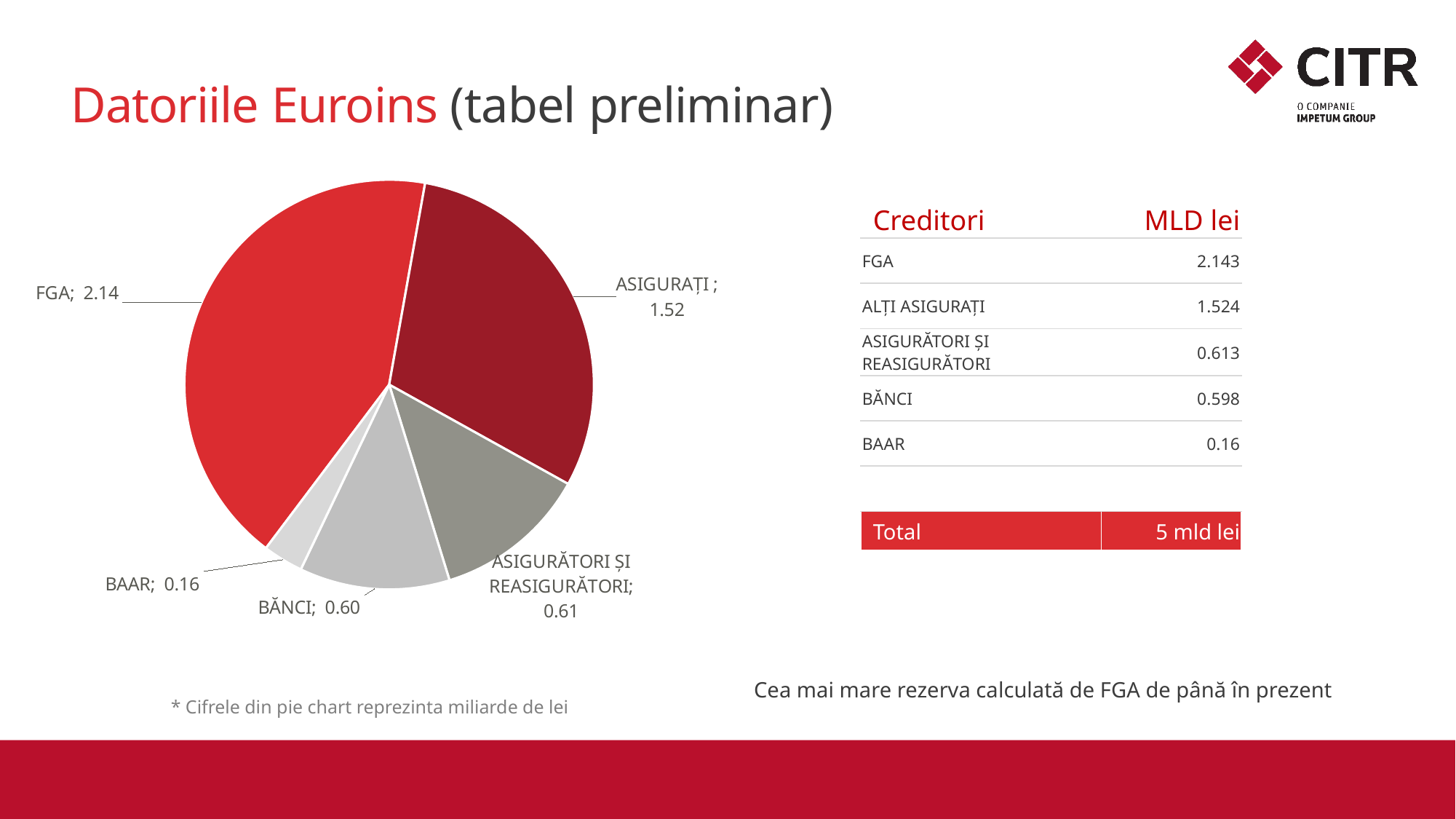
Which slice of the pie chart is the smallest? BAAR What is the value shown for BĂNCI in the pie chart? 0.60 According to the footnote, what unit do the figures in the pie chart represent? miliarde de lei Which slice of the pie chart is the largest? FGA What kind of chart is shown on the slide? pie chart What is the value shown for FGA in the pie chart? 2.14 What is the value shown for ASIGURĂTORI ȘI REASIGURĂTORI in the pie chart? 0.61 What is the value shown for BAAR in the pie chart? 0.16 Which is larger in the pie chart, the value for ASIGURAȚI or the value for BĂNCI? ASIGURAȚI What is the difference between the FGA value and the ASIGURAȚI value in the pie chart? 0.62 What is the value shown for ASIGURAȚI in the pie chart? 1.52 How many slices does the pie chart have? 5